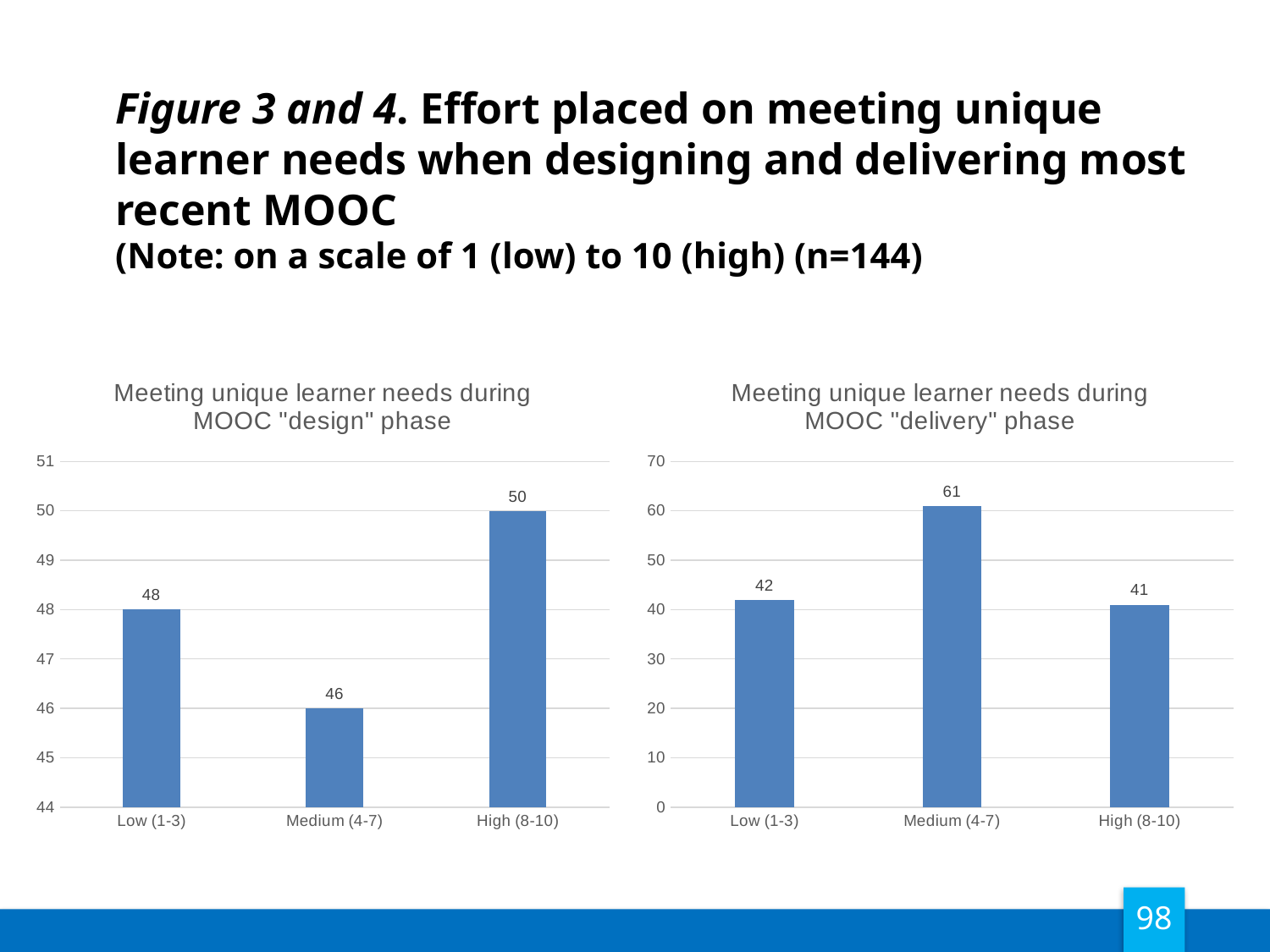
In the "delivery" phase chart, is the value for Medium (4-7) greater or less than 50? greater What kind of chart is the "design" phase chart? Bar chart How many categories are shown in the "delivery" phase chart? 3 In the "delivery" phase chart, which category has the highest value? Medium (4-7) In the "design" phase chart, what is the value for Low (1-3)? 48 In the "design" phase chart, what is the value for Medium (4-7)? 46 In the "delivery" phase chart, what is the value for High (8-10)? 41 In the "delivery" phase chart, what is the value for Medium (4-7)? 61 In the "design" phase chart, what is the difference between High (8-10) and Medium (4-7)? 4 In the "delivery" phase chart, what is the difference between Medium (4-7) and Low (1-3)? 19 In the "design" phase chart, which category has the highest value? High (8-10) In the "design" phase chart, which category has the lowest value? Medium (4-7)